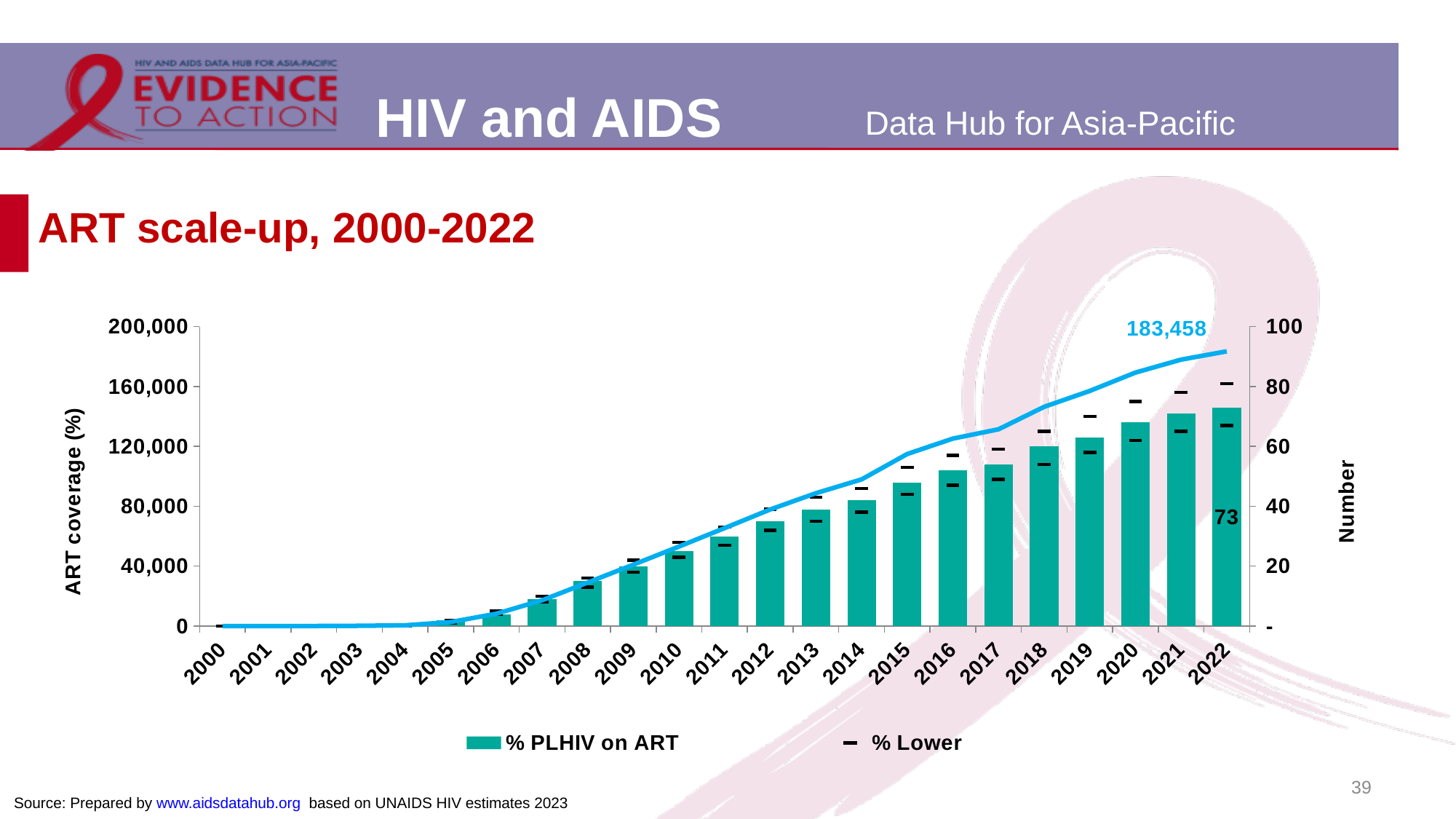
Is the % PLHIV on ART bar for 2005 greater or less than 20 on the right axis? less Which year has the highest % PLHIV on ART bar? 2022 How many years are shown on the x axis? 23 What is the value of % PLHIV on ART for 2022? 73 Which year has the larger % PLHIV on ART bar, 2012 or 2018? 2018 How many series does the legend list? 2 What value is labelled on the line at 2022? 183,458 Do the % PLHIV on ART bars rise or fall from 2000 to 2022? Rise Is the line value for 2017 greater or less than 120,000 on the left axis? greater What kind of chart is shown on the slide? Bar chart combined with a line Is the % PLHIV on ART bar for 2015 greater or less than 40 on the right axis? greater What is the title of the chart? ART scale-up, 2000-2022